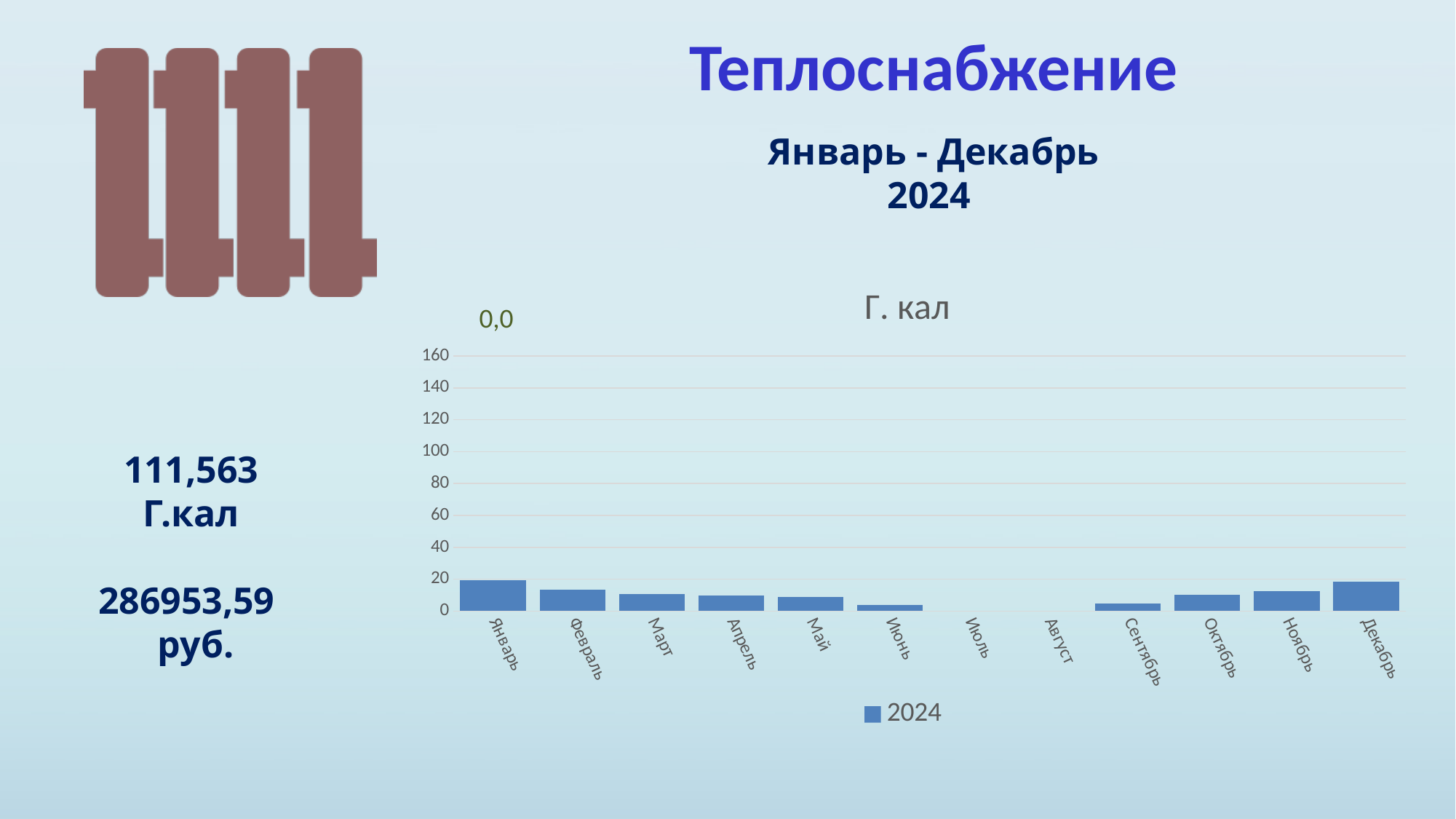
Which is larger, the value for Февраль or the value for Июнь? Февраль How many months (categories) are shown on the x axis of the chart? 12 Is the value for Январь greater or less than 40? less Is the value for Декабрь greater or less than 10? greater Do the values rise or fall from Сентябрь to Декабрь? rise What kind of chart is shown on the slide? bar chart What is the title of the chart? Г. кал Do the values rise or fall from Январь to Июль? fall Which is larger, the value for Ноябрь or the value for Сентябрь? Ноябрь How many series does the chart legend list? 1 Is the value for Февраль greater or less than 20? less What series name is shown in the chart legend? 2024